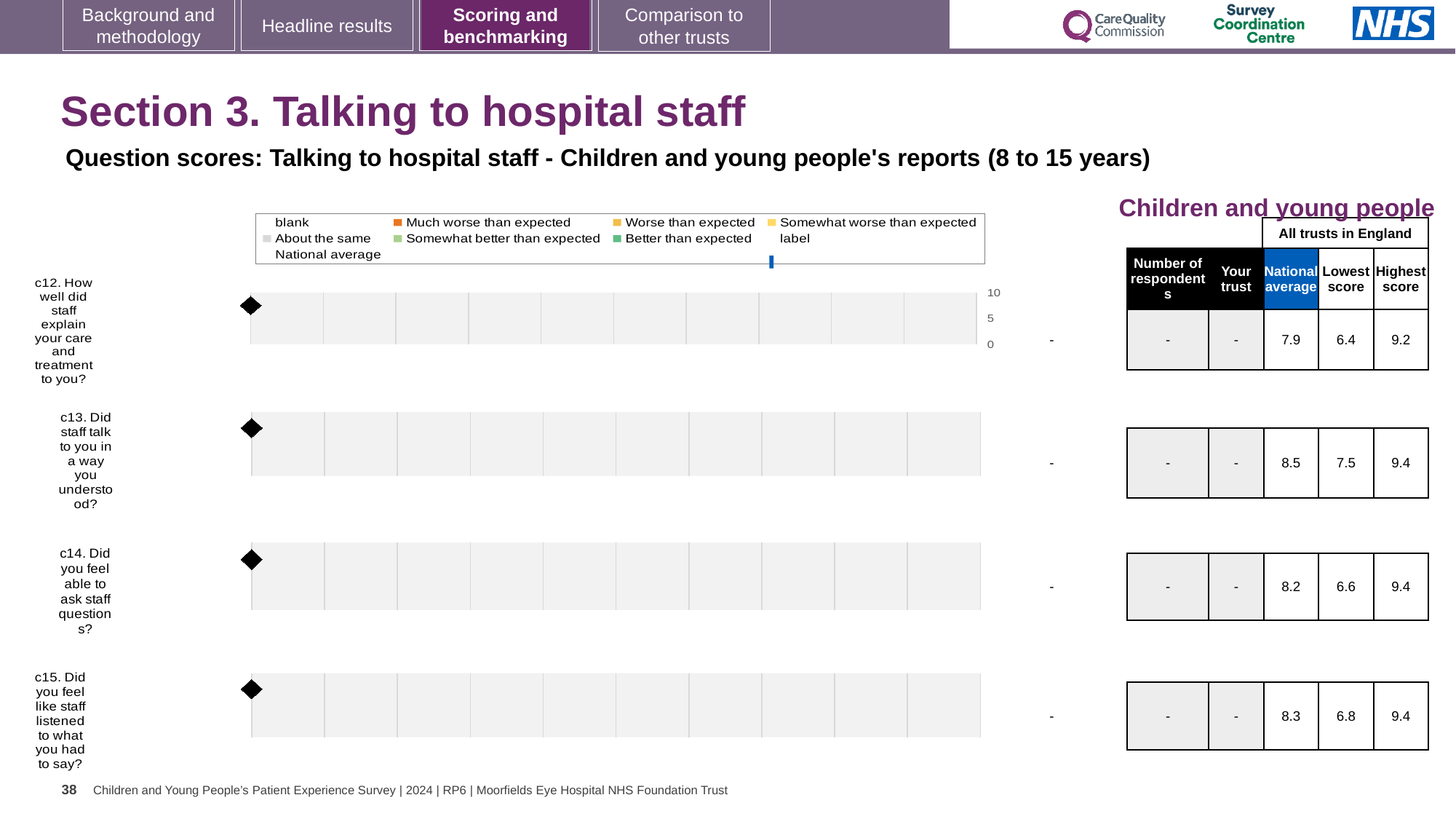
In the table next to the c12 chart, what is the National average score? 7.9 What kind of chart is used for question c12 on the slide? bar chart What is the difference between the Highest score and the Lowest score for c12 in the table? 2.8 Which question (c12, c13, c14 or c15) has the lowest Lowest score in the table? c12 What is the highest tick value shown on the axis of the c12 chart? 10 In the table next to the c15 chart, what is the National average score? 8.3 Which question (c12, c13, c14 or c15) has the highest National average score in the table? c13 In the table next to the c13 chart, what is the Lowest score? 7.5 In the table next to the c14 chart, what is the Highest score? 9.4 What is the last entry listed in the chart legend? National average Is the National average score for c14 larger than the National average score for c12? Yes How many question charts (c12 to c15) are shown on the slide? 4